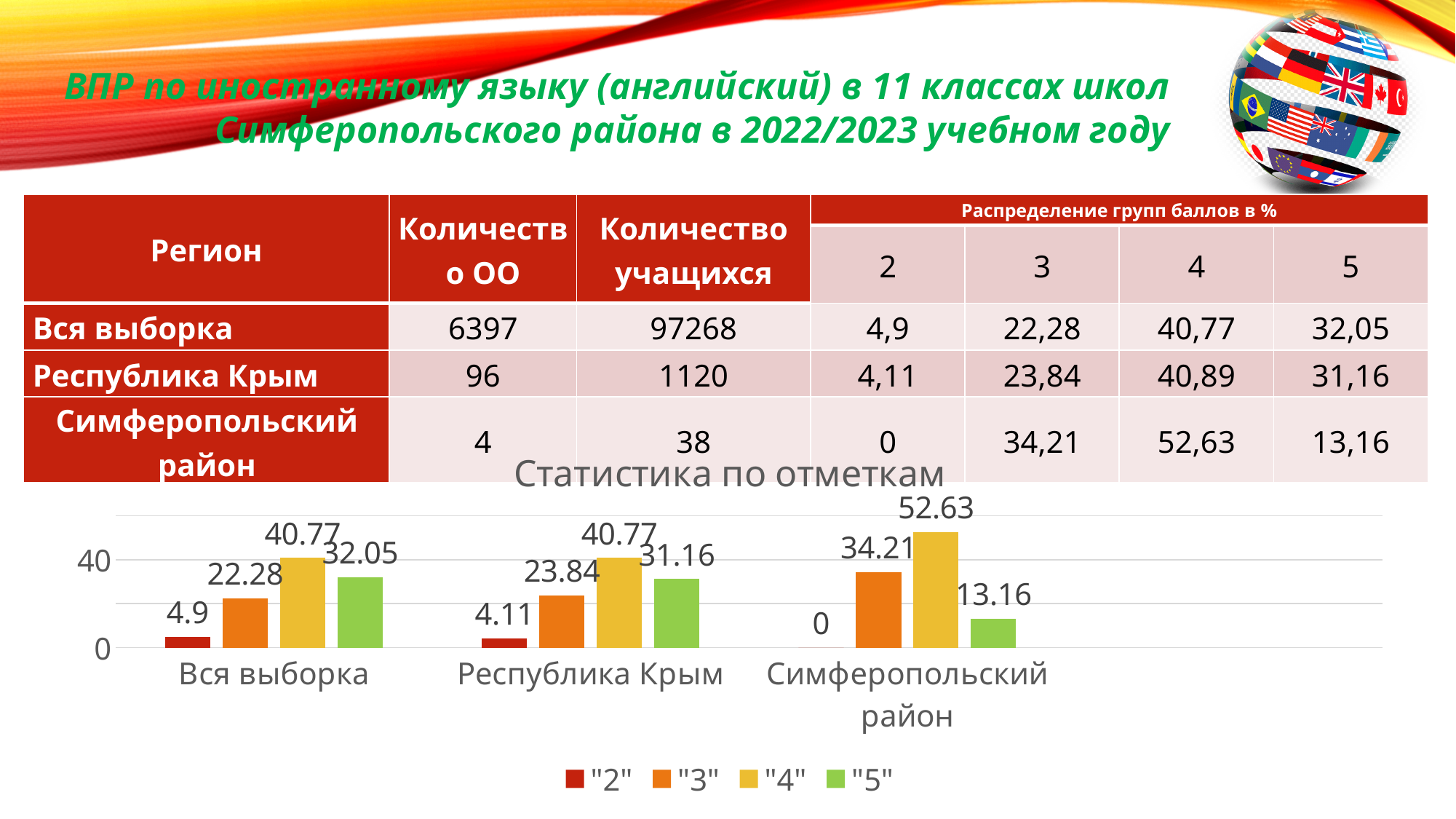
What type of chart is shown on the slide? bar chart What is the value of series "4" for Симферопольский район in the chart? 52.63 How many categories are shown on the x axis of the chart? 3 Which series has the lowest value for Республика Крым in the chart? "2" Which series has the highest value for Симферопольский район in the chart? "4" What is the value of series "3" for Республика Крым in the chart? 23.84 Is the value of series "4" for Симферопольский район greater or less than 40? greater What is the value of series "2" for Вся выборка in the chart? 4.9 Which is larger in the chart: series "5" for Вся выборка or series "5" for Симферопольский район? Вся выборка What is the title of the chart? Статистика по отметкам What is the difference between the values of series "4" and series "5" for Симферопольский район in the chart? 39.47 How many series does the chart legend list? 4